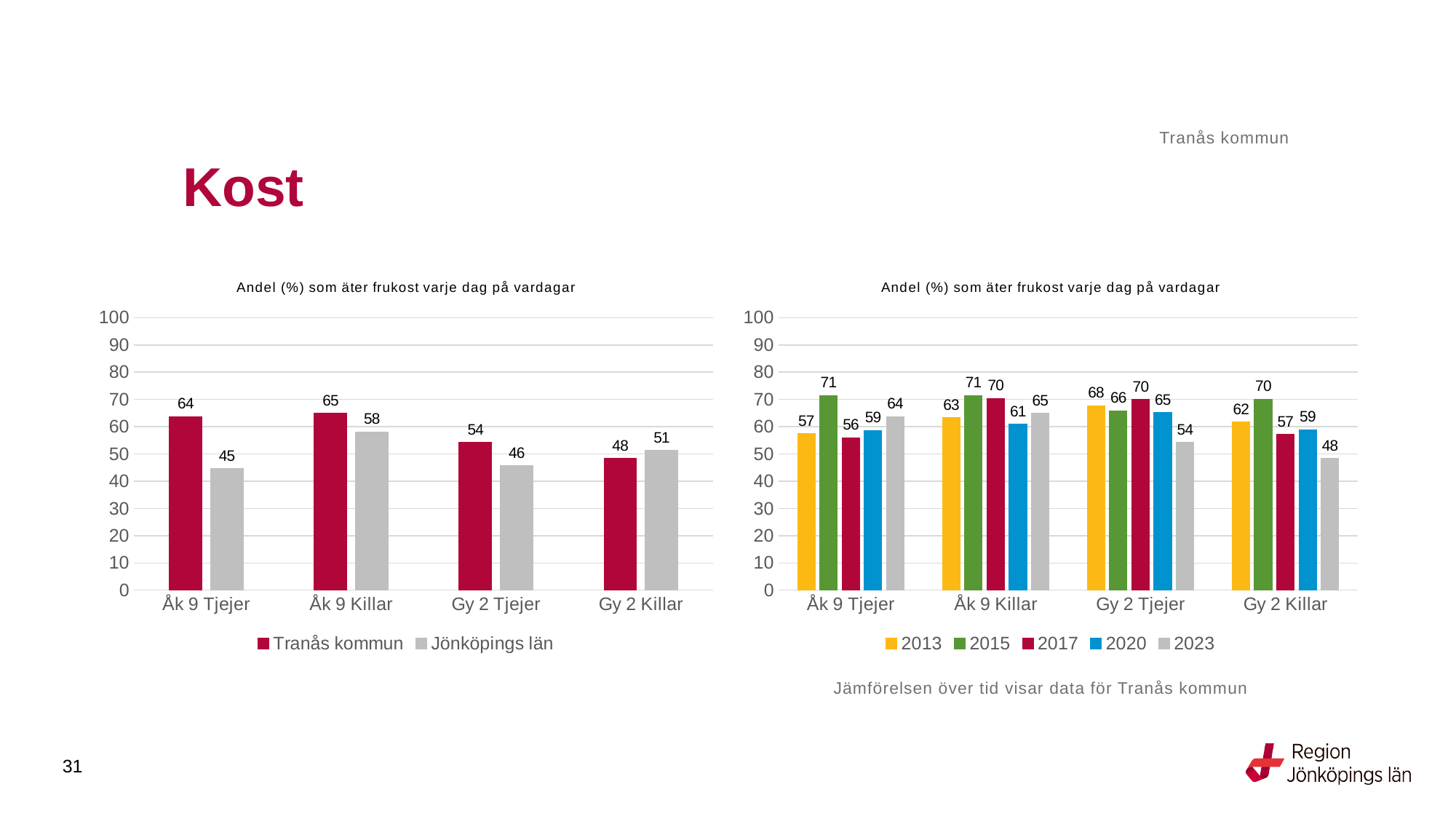
In the left chart, which category has the lowest value for Tranås kommun? Gy 2 Killar In the right chart, how many series does the legend list? 5 In the left chart, what is the value for Jönköpings län for Gy 2 Killar? 51 In the right chart, what is the value for 2013 for Åk 9 Killar? 63 In the left chart, what is the value for Tranås kommun for Åk 9 Tjejer? 64 In the left chart, how many series does the legend list? 2 In the left chart, which is larger for Gy 2 Killar: Tranås kommun or Jönköpings län? Jönköpings län In the right chart, what is the value for 2023 for Gy 2 Tjejer? 54 In the right chart, which year has the highest value for Gy 2 Killar? 2015 What type of chart is the right chart? Bar chart In the right chart, what is the difference between the 2015 and 2023 values for Gy 2 Killar? 22 In the left chart, what is the difference between Tranås kommun and Jönköpings län for Åk 9 Tjejer? 19